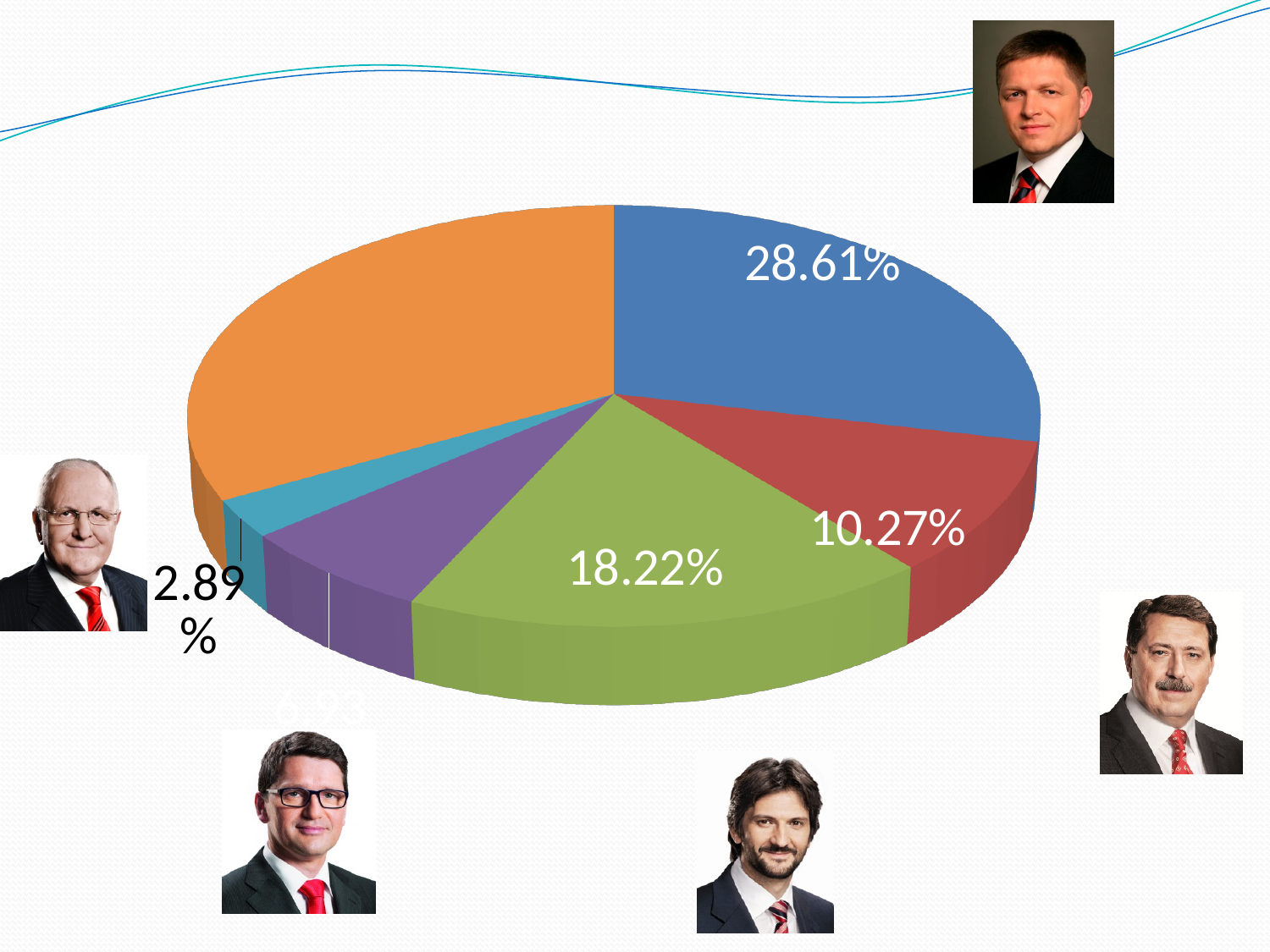
What is the difference between the blue slice (28.61%) and the red slice (10.27%)? 18.34% How many slices does the pie chart have? 6 What value is shown on the small teal slice of the pie chart? 2.89% Which is larger, the blue slice or the red slice? the blue slice Which is larger, the green slice or the red slice? the green slice What value is shown on the green slice of the pie chart? 18.22% What is the difference between the green slice (18.22%) and the red slice (10.27%)? 7.95% Which slice of the pie chart is the smallest? the teal slice (2.89%) What kind of chart is shown on the slide? pie chart What value is shown on the blue slice of the pie chart? 28.61% What value is shown on the red slice of the pie chart? 10.27% What colour is the slice labelled 28.61%? blue